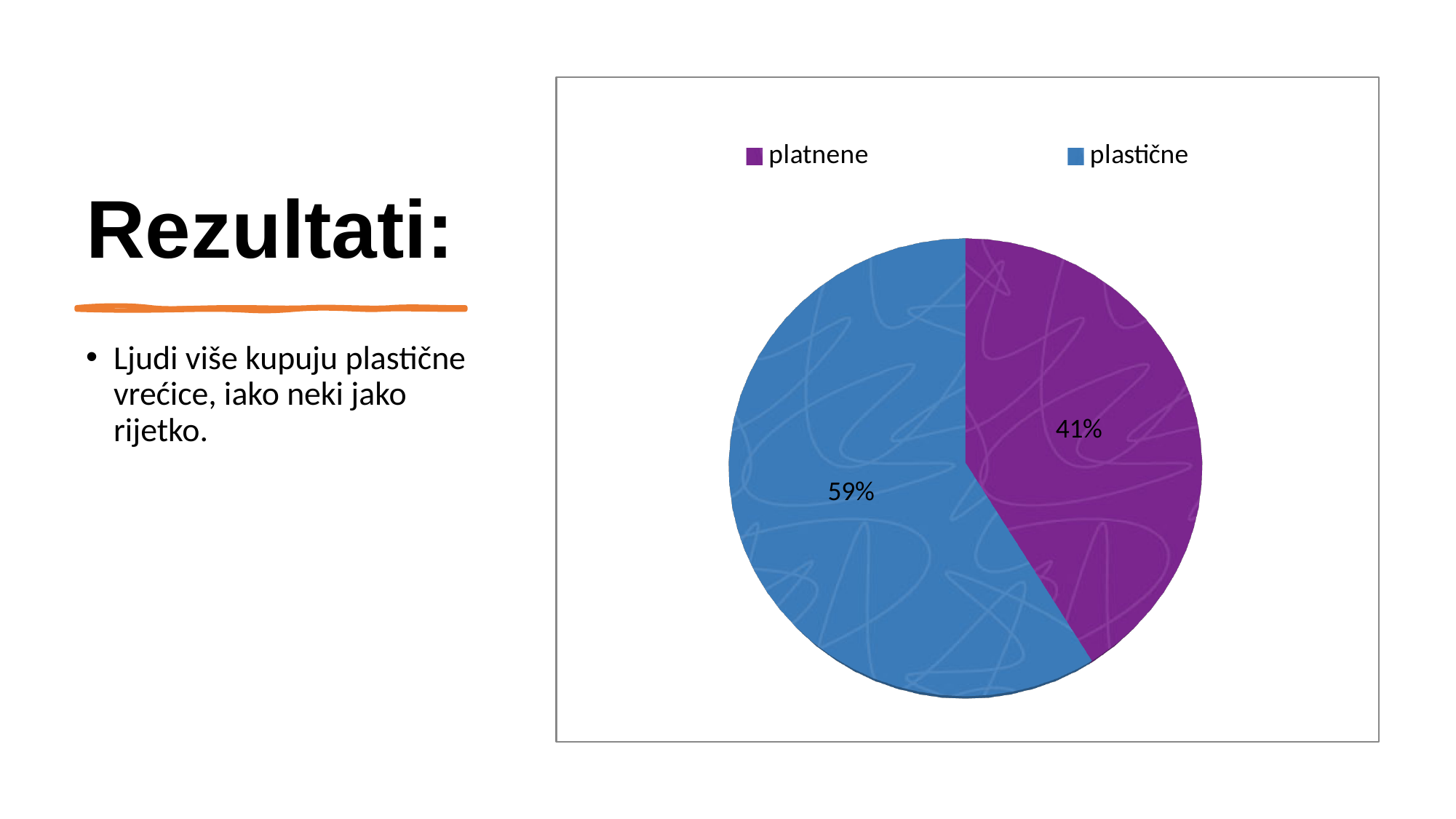
Which category has the smallest slice of the pie? platnene What kind of chart is shown on the slide? pie chart What share of the pie does the 'plastične' slice represent? 59% How many slices does the pie chart have? 2 What colour is the 'platnene' slice? purple Which category has the largest slice of the pie? plastične Which is larger, the 'platnene' slice or the 'plastične' slice? plastične How many entries does the legend list? 2 What colour is the 'plastične' slice? blue What share of the pie does the 'platnene' slice represent? 41% What is the difference in percentage points between the 'plastične' and 'platnene' slices? 18